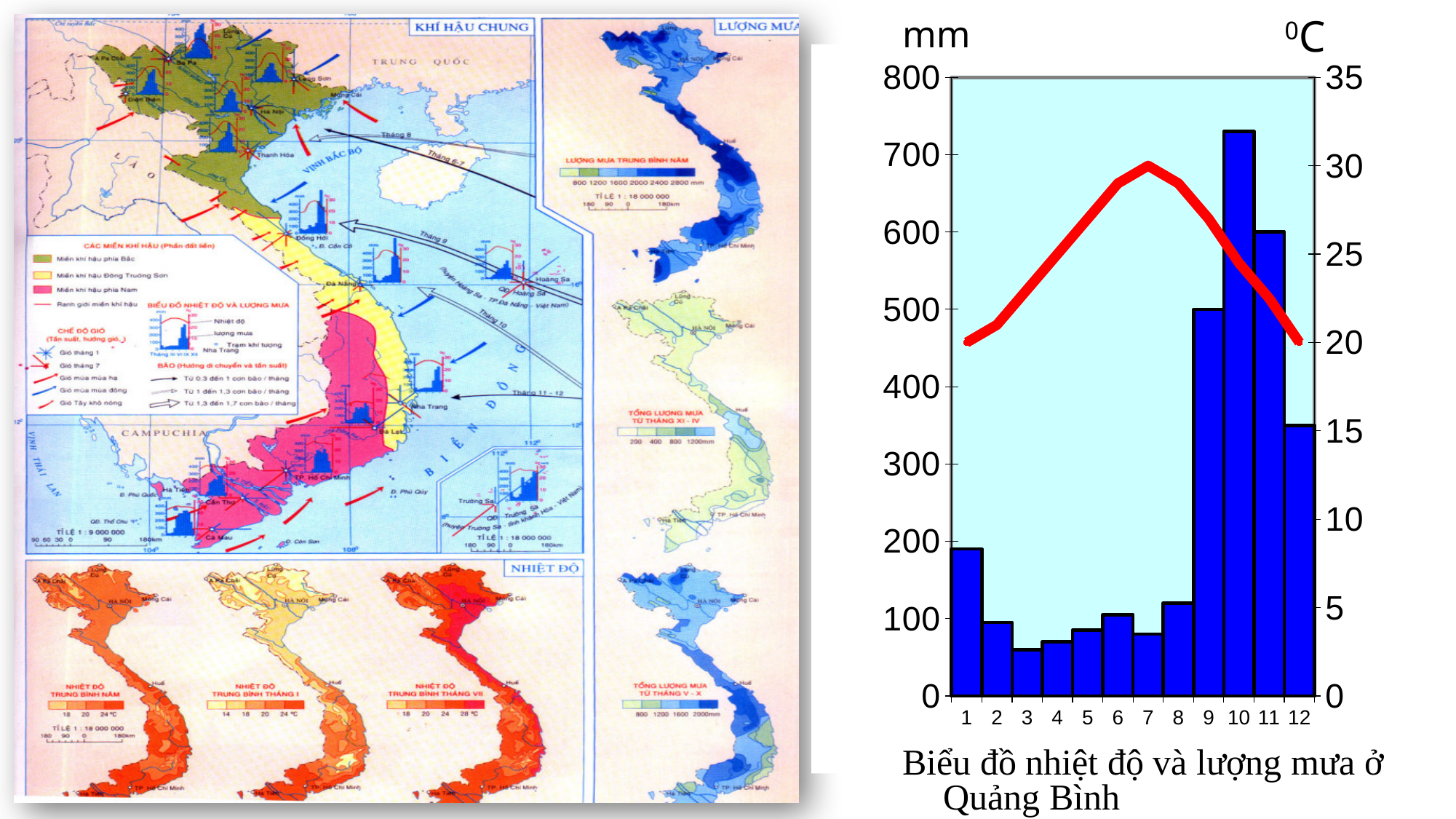
In the chart on the right, which month has the highest rainfall bar? 10 What is the title of the chart on the right side of the slide? Biểu đồ nhiệt độ và lượng mưa ở Quảng Bình In the chart on the right, how many months are shown on the x axis? 12 In the chart on the right, does the temperature line rise or fall from month 1 to month 7? rise In the chart on the right, what kind of chart is used to show the rainfall values? bar chart In the chart on the right, which month has the larger rainfall bar, month 9 or month 11? 11 In the chart on the right, which month has the lowest rainfall bar? 3 In the chart on the right, is the rainfall for month 10 greater or less than 700 mm? greater In the chart on the right, what unit is shown on the left vertical axis? mm In the chart on the right, is the rainfall for month 12 greater or less than 300 mm? greater In the chart on the right, is the rainfall for month 3 greater or less than 100 mm? less